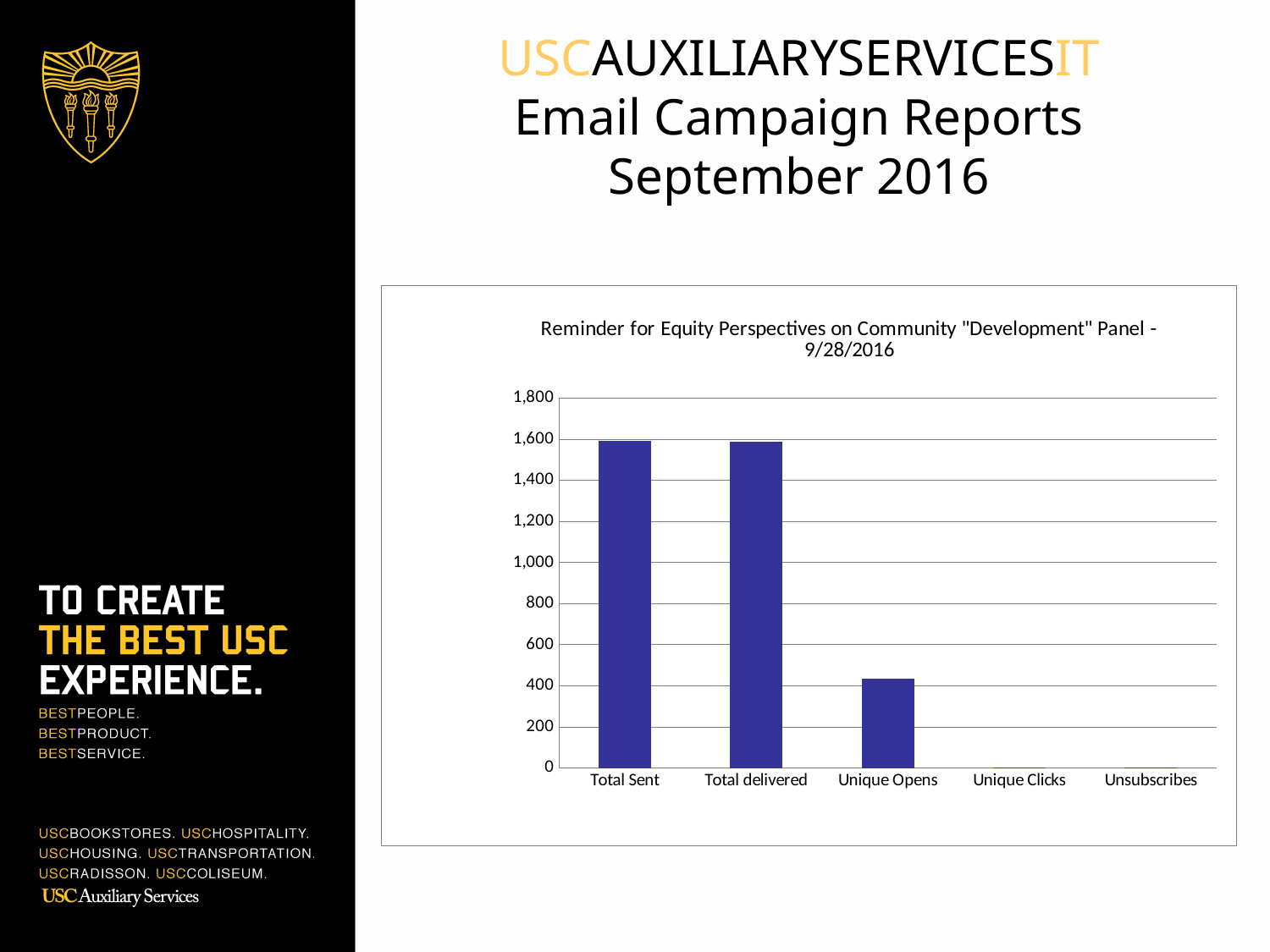
Is the value for Unique Opens greater or less than 200? greater Is the value for Unique Opens greater or less than 600? less What is the title of the chart? Reminder for Equity Perspectives on Community "Development" Panel - 9/28/2016 Is the value for Total delivered greater or less than 1,800? less What is the highest value shown on the y axis of the chart? 1,800 What kind of chart is shown on the slide? bar chart Which is larger, the value for Unique Opens or the value for Unsubscribes? Unique Opens Which is larger, the value for Total Sent or the value for Unique Opens? Total Sent How many categories are shown on the x axis of the chart? 5 Do the values generally rise or fall moving from left to right along the x axis? fall